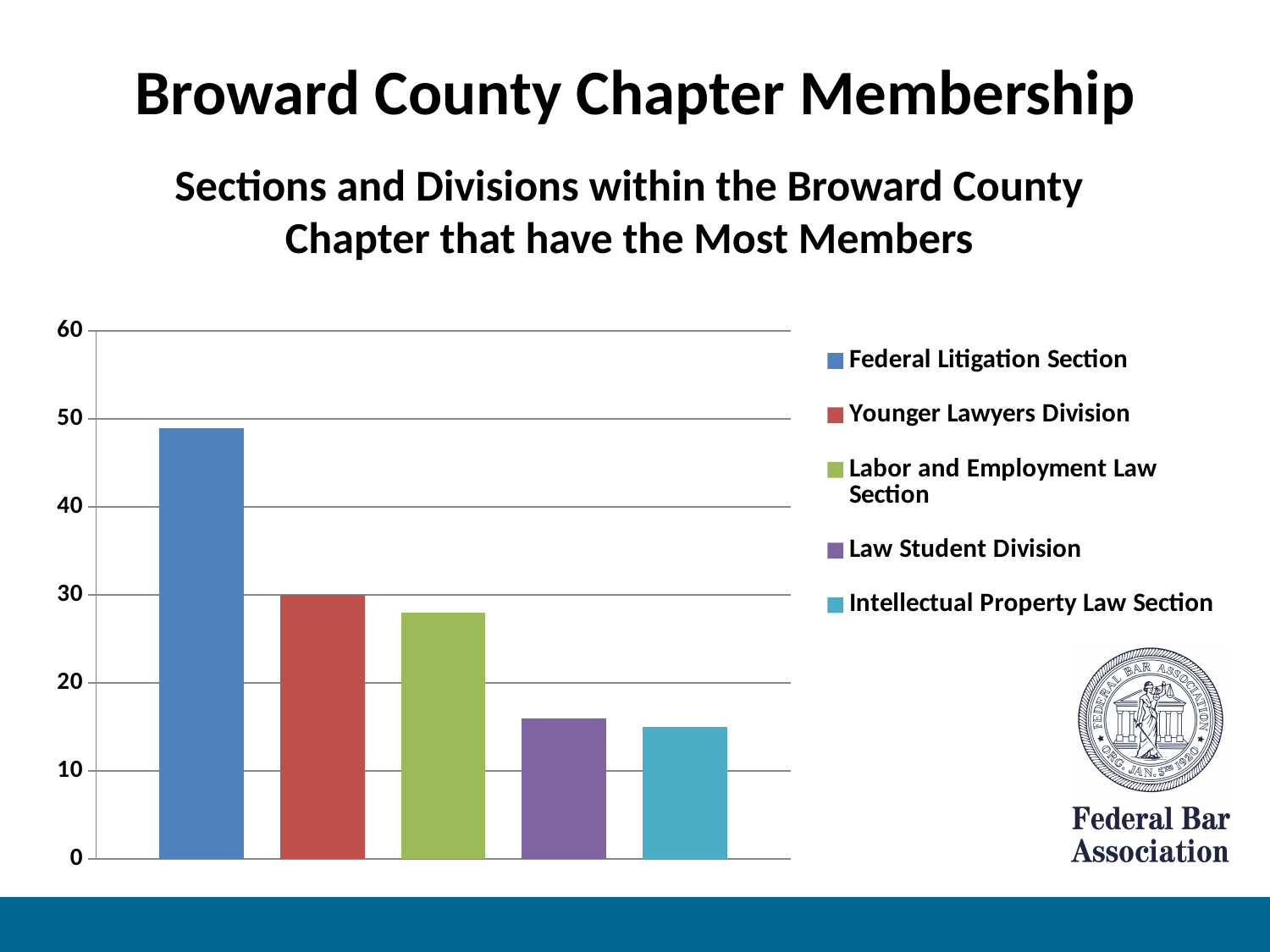
Is the value for the Labor and Employment Law Section greater or less than 30? less Is the value for the Intellectual Property Law Section greater or less than 10? greater What kind of chart is shown on the slide? bar chart Which has more members, the Federal Litigation Section or the Younger Lawyers Division? Federal Litigation Section How many entries does the chart's legend list? 5 How many bars are plotted in the chart? 5 Which section or division has the highest membership in the chart? Federal Litigation Section Do the bar values rise or fall from left to right across the chart? fall Is the value for the Law Student Division greater or less than 20? less Which has more members, the Labor and Employment Law Section or the Law Student Division? Labor and Employment Law Section